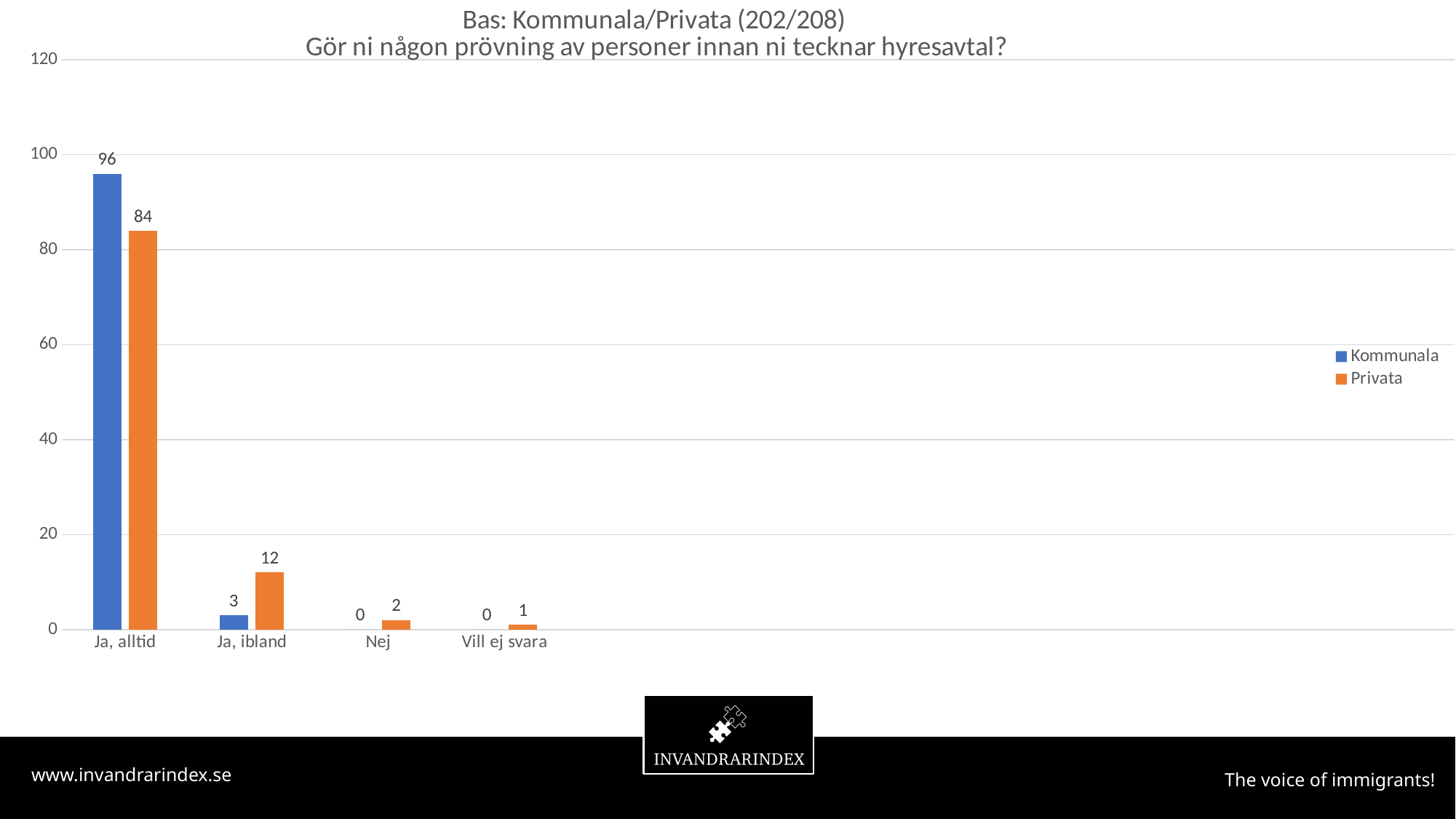
What is the Kommunala value for "Ja, alltid"? 96 Which category has the lowest Privata value? Vill ej svara How many series does the legend list? 2 What is the Privata value for "Ja, ibland"? 12 Which is larger for "Ja, ibland": Kommunala or Privata? Privata What kind of chart is shown on the slide? Bar chart How many categories are shown on the x axis? 4 Which category has the highest Privata value? Ja, alltid What is the Privata value for "Nej"? 2 Is the Privata value for "Ja, alltid" greater or less than 80? greater What is the difference between the Kommunala and Privata values for "Ja, alltid"? 12 What is the Kommunala value for "Vill ej svara"? 0